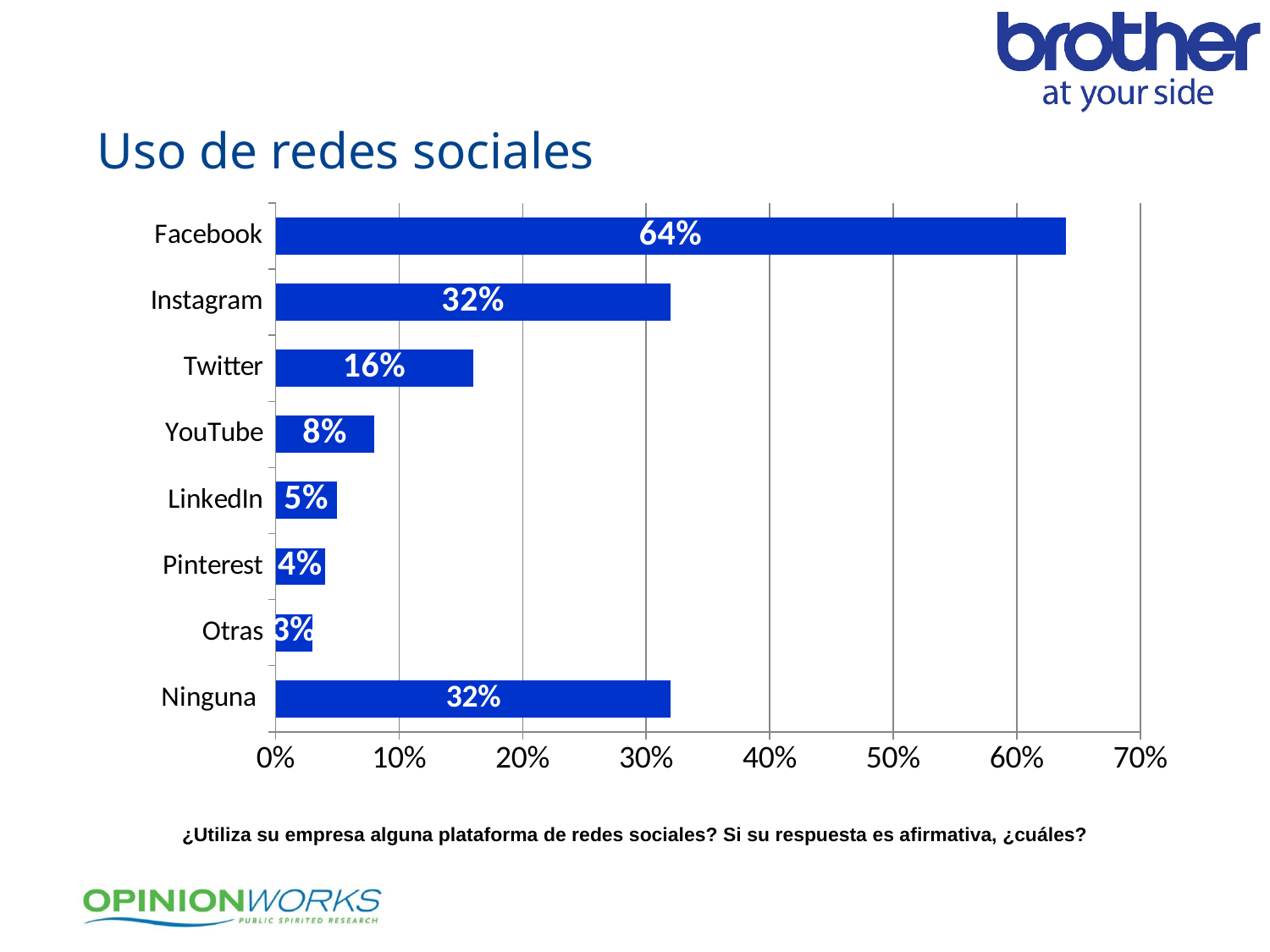
Which category has the lowest value? Otras How many categories are shown in the chart? 8 What is the title of the chart? Uso de redes sociales What kind of chart is shown on the slide? Bar chart What is the difference between the values for Facebook and Instagram? 32% What is the value for LinkedIn? 5% What is the value for Twitter? 16% Which category has the highest value? Facebook What is the value for Ninguna? 32% What is the value for Facebook? 64% Which is larger, the value for Twitter or the value for YouTube? Twitter What is the difference between the values for YouTube and Pinterest? 4%